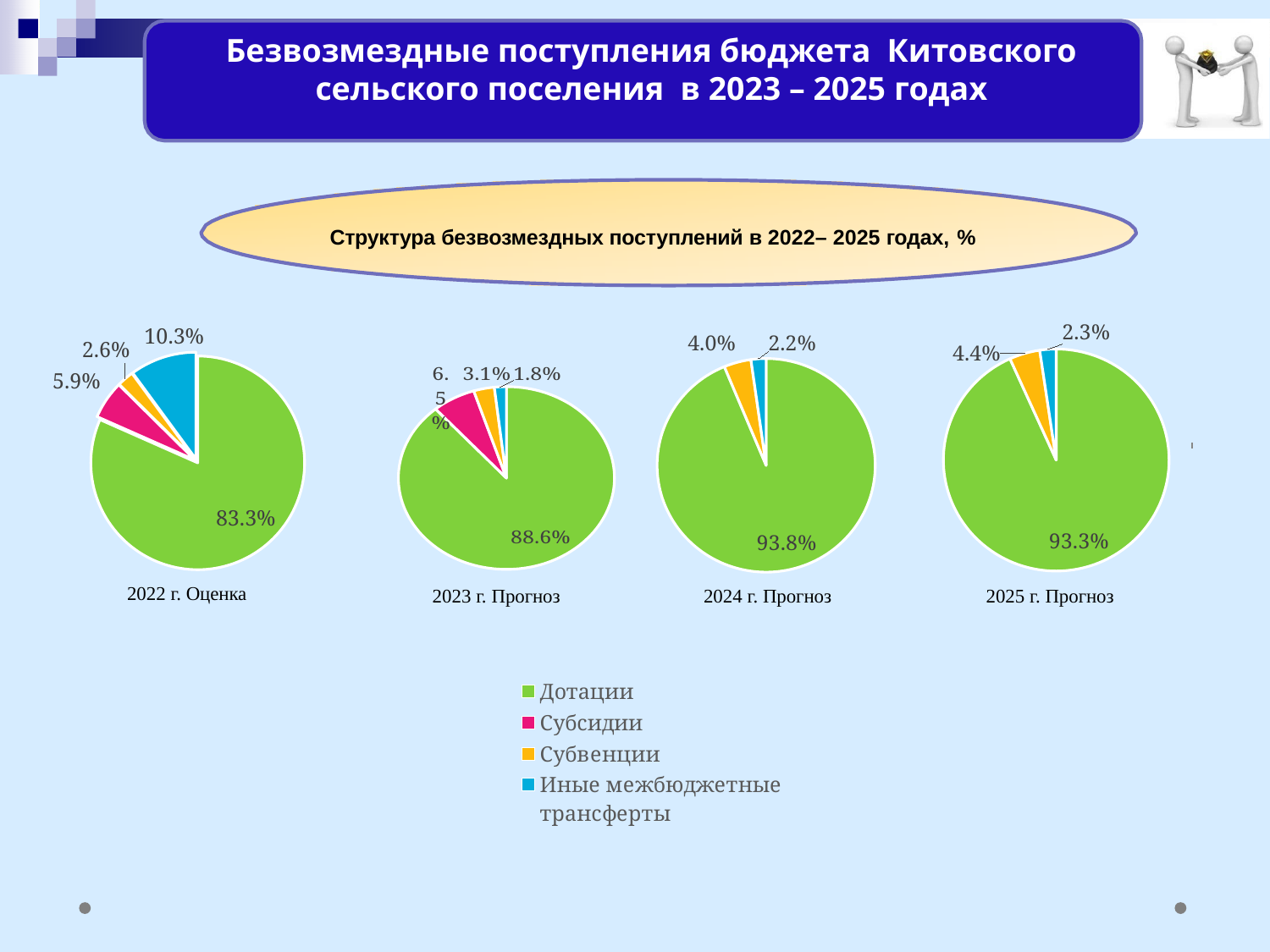
What kind of charts are shown on the slide? Pie charts In the 2022 г. Оценка pie chart, what is the share of Дотации? 83.3% In the 2025 г. Прогноз pie chart, what is the share of Иные межбюджетные трансферты? 2.3% What is the difference between the Дотации share in the 2024 г. Прогноз chart and in the 2022 г. Оценка chart? 10.5% How many series does the legend list? 4 In the 2022 г. Оценка pie chart, what is the share of Иные межбюджетные трансферты? 10.3% How many pie charts are on the slide? 4 In the 2023 г. Прогноз pie chart, what is the share of Субвенции? 3.1% In the 2024 г. Прогноз pie chart, what is the share of Субвенции? 4.0% In the 2022 г. Оценка pie chart, what is the share of Субсидии? 5.9% In the 2023 г. Прогноз pie chart, what is the share of Дотации? 88.6% In the 2025 г. Прогноз pie chart, which category has the largest share? Дотации